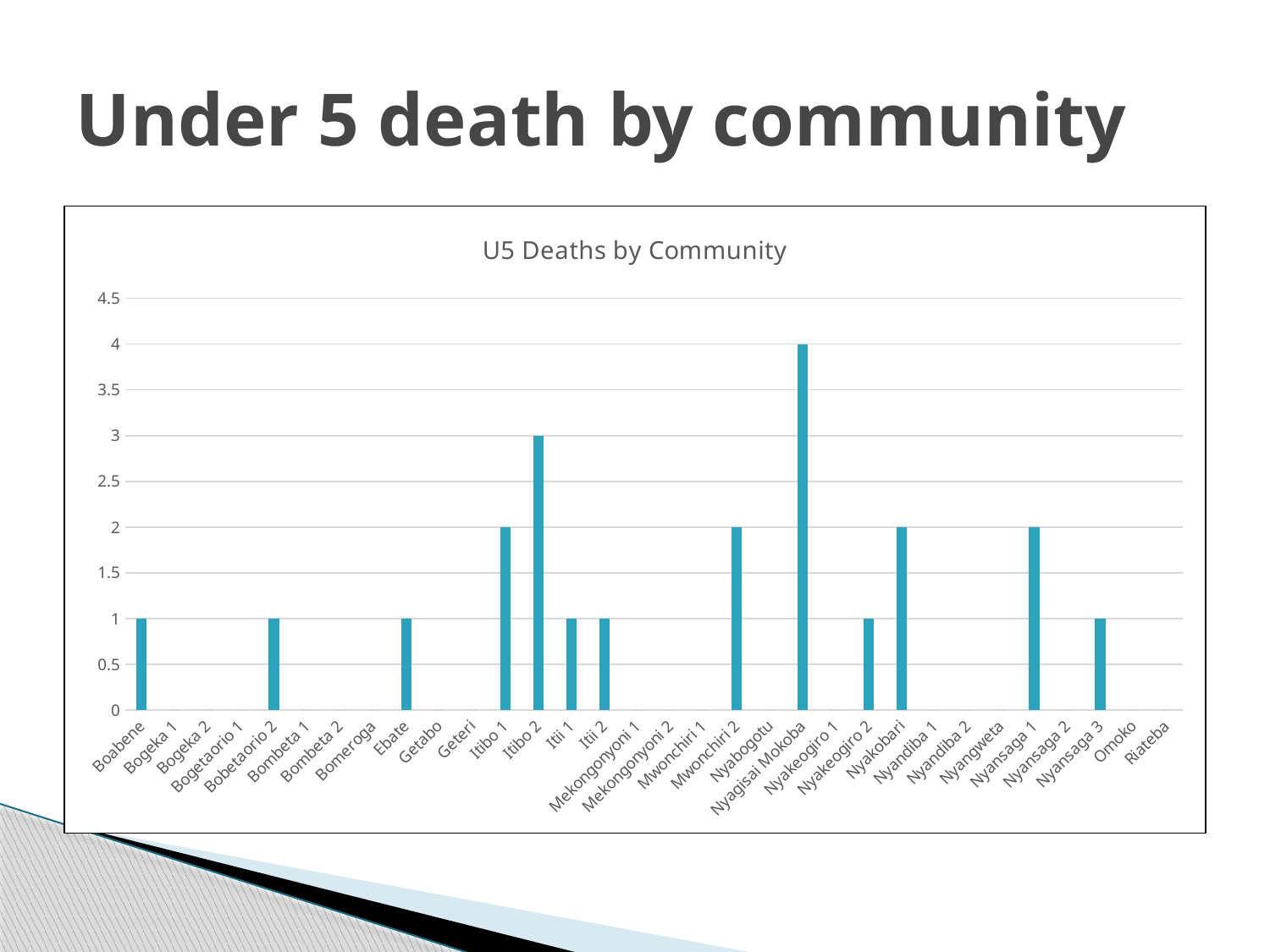
How many under-5 deaths are shown for Itibo 2? 3 What is the difference in under-5 deaths between Nyagisai Mokoba and Itibo 2? 1 Is the value for Nyagisai Mokoba greater or less than 3? greater What type of chart is shown on the slide? Bar chart How many communities have a bar showing at least one under-5 death? 13 Which has more under-5 deaths, Itibo 1 or Itibo 2? Itibo 2 How many under-5 deaths are shown for Nyakobari? 2 How many communities are listed on the x axis? 32 How many under-5 deaths are shown for Ebate? 1 How many under-5 deaths are shown for Nyagisai Mokoba? 4 What is the title of the chart? U5 Deaths by Community Which community has the highest number of under-5 deaths? Nyagisai Mokoba